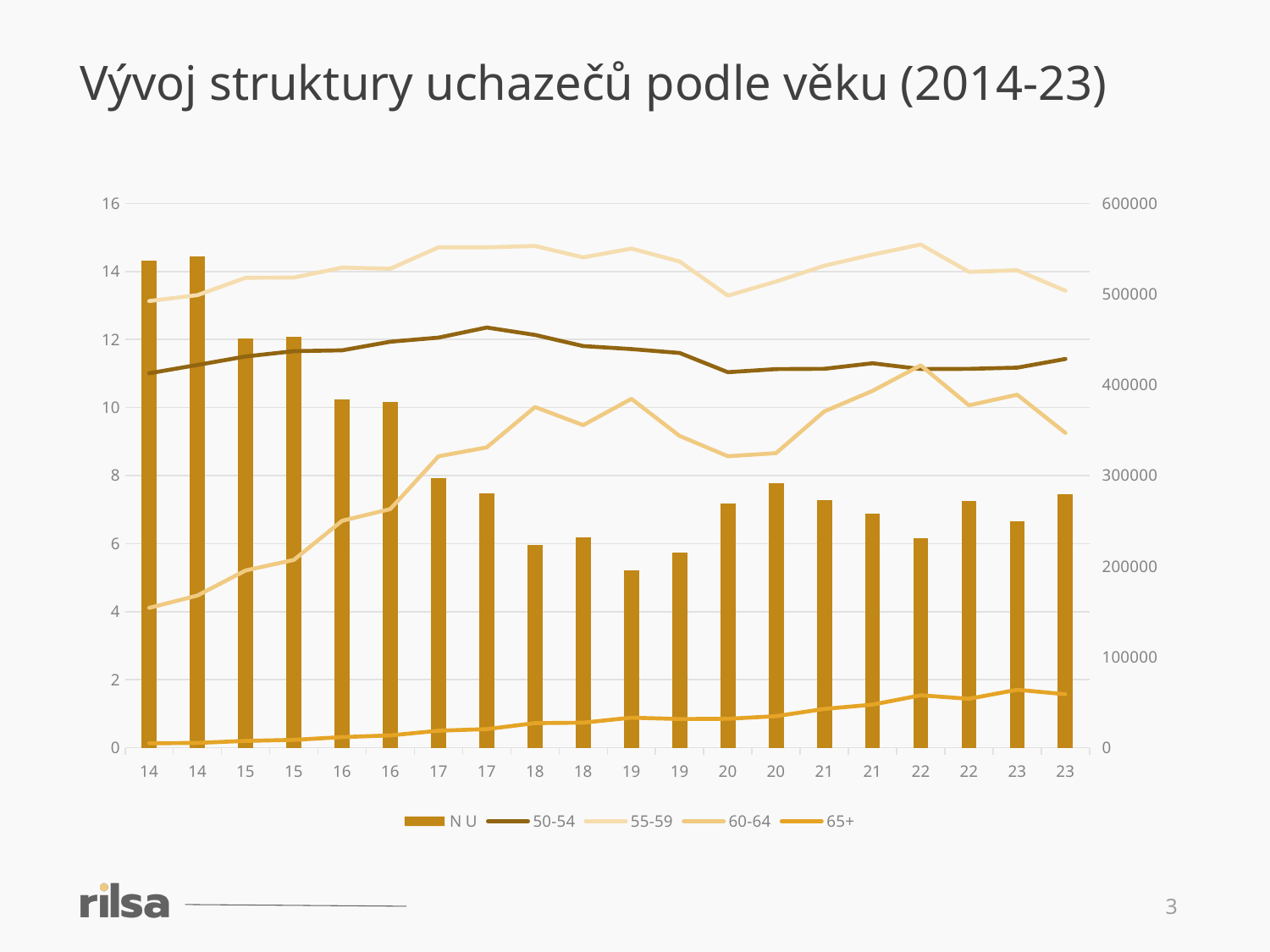
What kind of chart is shown on the slide? A combined bar and line chart Which x-axis label has the lowest N U bar? The first 19 Is the 55-59 line at the first 22 label greater or less than 14 on the left axis? greater Does the 60-64 line generally rise or fall from 14 to 23? rise At the second 23 label, which line is higher: 50-54 or 60-64? 50-54 At the first 14 label, which line is higher: 55-59 or 50-54? 55-59 How many series does the legend list? 5 What is the title of the chart? Vývoj struktury uchazečů podle věku (2014-23) Is the 65+ line at the second 23 label greater or less than 2 on the left axis? less How many bars are plotted in the N U series? 20 Is the N U bar at the first 19 label greater or less than 300000 on the right axis? less